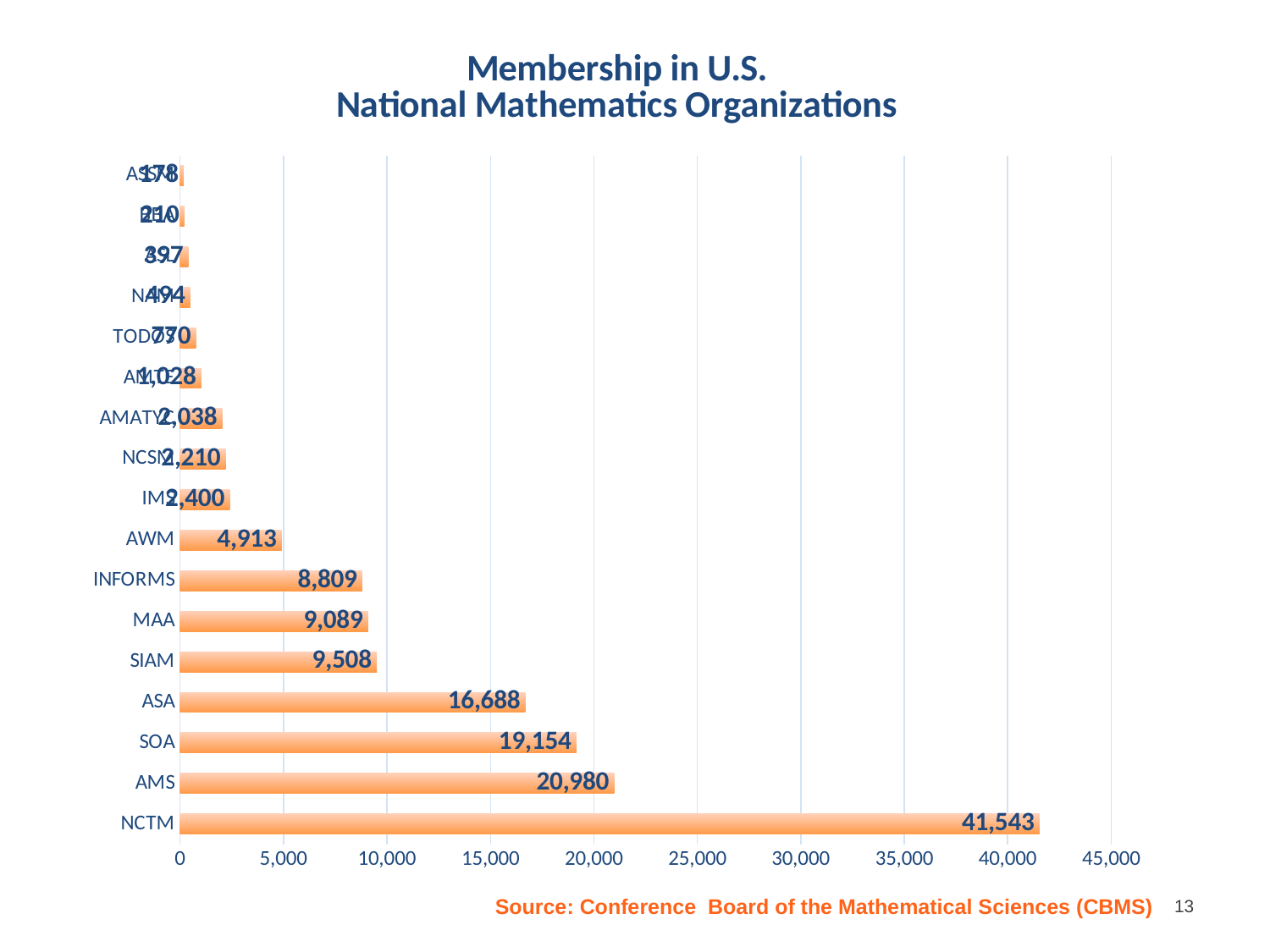
Which organization has the highest membership? NCTM What is the title of the chart? Membership in U.S. National Mathematics Organizations What is the difference in membership between AMS and SOA? 1,826 What is the membership value for AWM? 4,913 Is the membership value for ASA greater or less than 15,000? greater What is the membership value for AMS? 20,980 How many organizations (bars) are shown in the chart? 17 What is the membership value for NCTM? 41,543 What kind of chart is shown on the slide? bar chart Which has a larger membership, MAA or INFORMS? MAA What is the difference in membership between NCTM and ASA? 24,855 What is the membership value for SIAM? 9,508